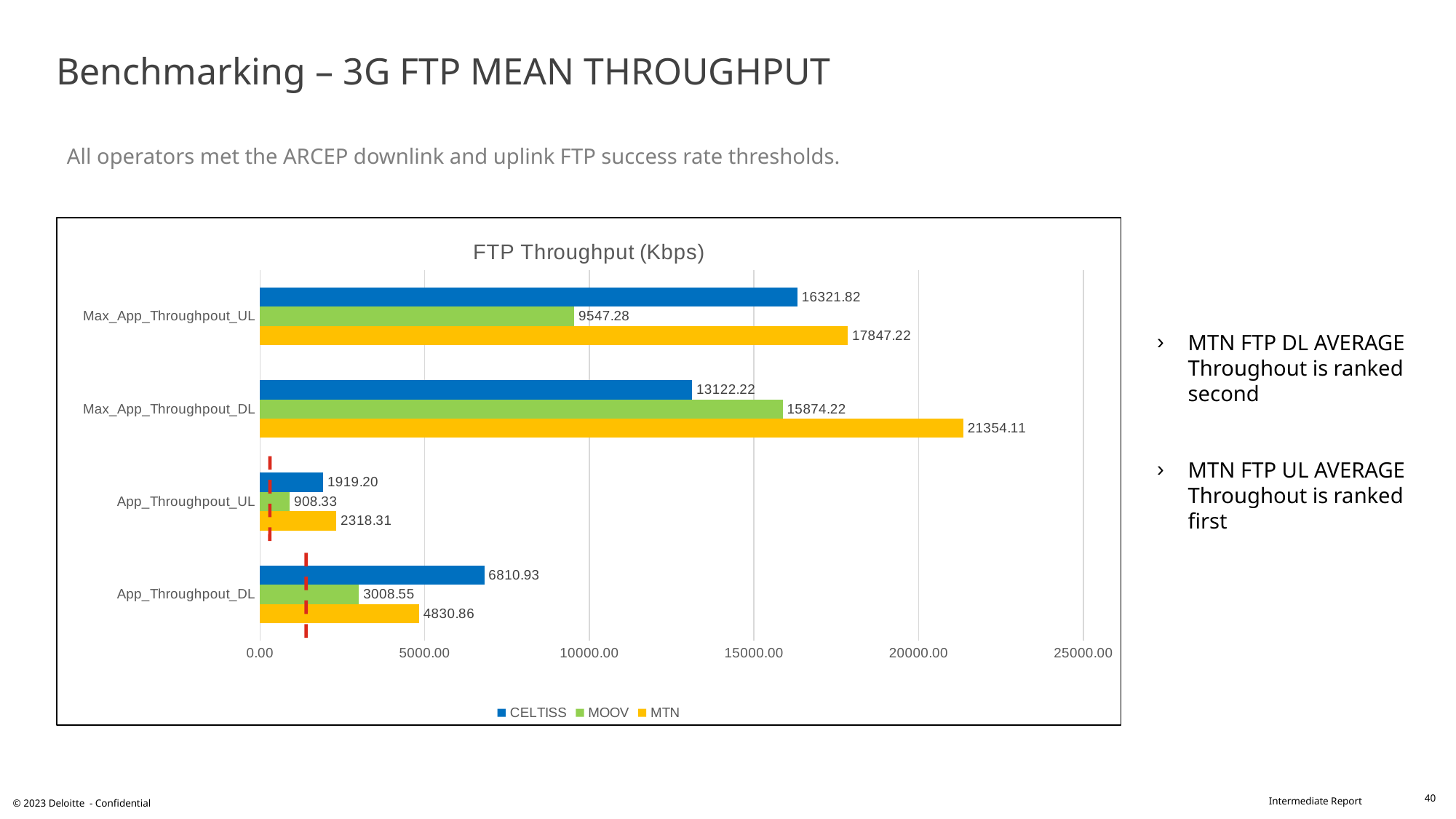
Which operator has the lowest value for App_Throughpout_DL? MOOV How many categories are shown on the chart? 4 What kind of chart is shown on the slide? Bar chart What is the difference between the MTN and CELTISS values for App_Throughpout_UL? 399.11 What is the MTN value for Max_App_Throughpout_DL? 21354.11 Which operator has the highest value for Max_App_Throughpout_UL? MTN What is the title of the chart? FTP Throughput (Kbps) How many series does the legend list? 3 What is the MOOV value for App_Throughpout_UL? 908.33 Is the MTN value for Max_App_Throughpout_UL greater or less than 15000.00? greater What is the CELTISS value for App_Throughpout_DL? 6810.93 Which is larger for Max_App_Throughpout_DL: the CELTISS value or the MOOV value? MOOV